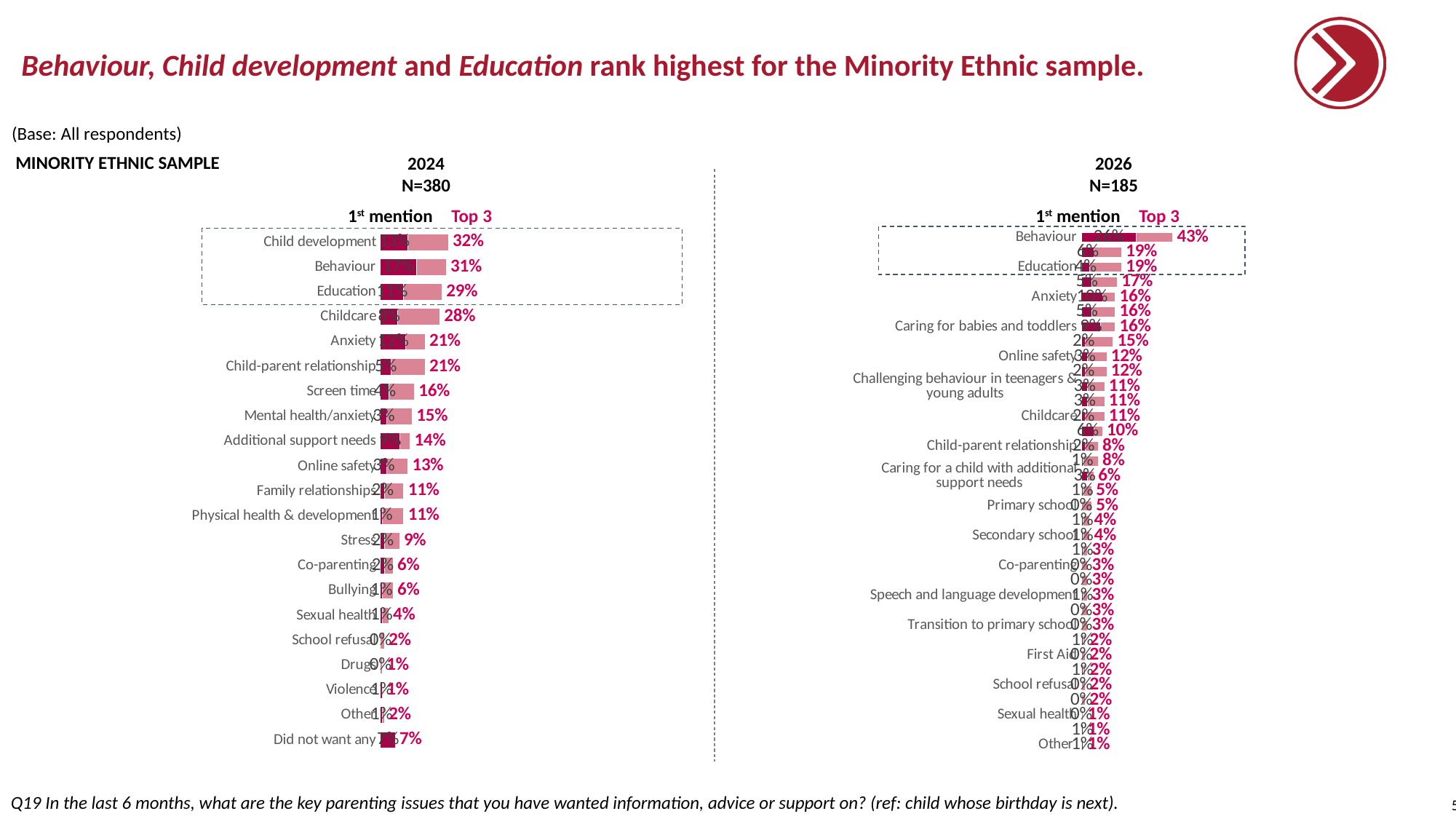
In the 2024 chart, what is the Top 3 value for Childcare? 28% In the 2026 chart, what is the Top 3 value for Caring for babies and toddlers? 16% In the 2024 chart, what is the difference between the Top 3 values for Child development and Education? 3% What type of chart is used on this slide? Bar chart In the 2024 chart, which has the larger Top 3 value, Screen time or Online safety? Screen time In the 2026 chart, what is the Top 3 value for Behaviour? 43% In the 2026 chart, which has the larger Top 3 value, Online safety or Childcare? Online safety In the 2026 chart, which category has the highest Top 3 value? Behaviour In the 2024 chart, what is the Top 3 value for Child development? 32% What is the sample size (N) shown for the 2026 chart? N=185 In the 2026 chart, what is the difference between the Top 3 values for Behaviour and Education? 24% In the 2024 chart, which category has the highest Top 3 value? Child development